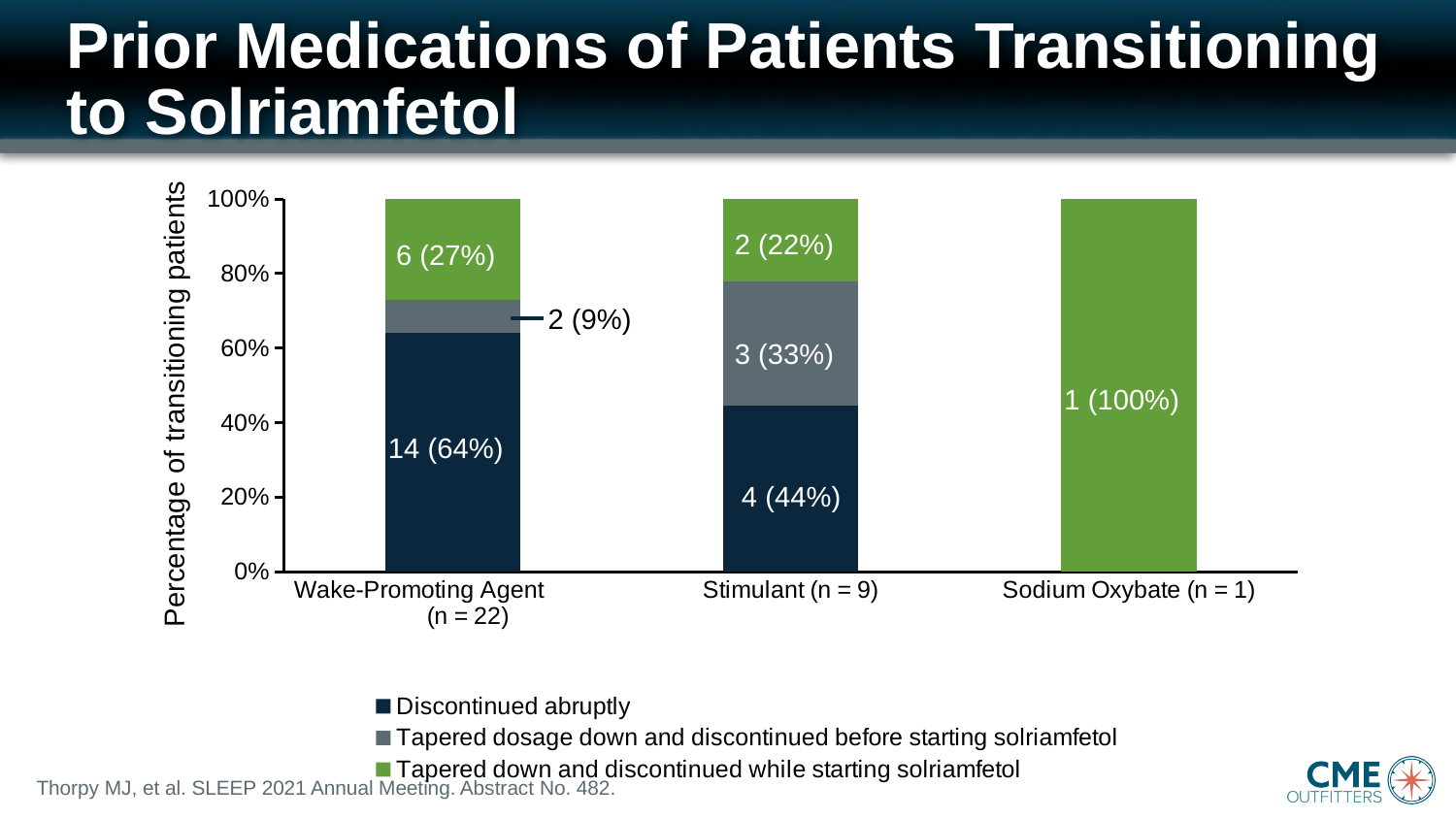
How many series does the legend list? 3 Which category has the highest percentage of patients who discontinued abruptly? Wake-Promoting Agent (n = 22) What is the label for the 'Tapered down and discontinued while starting solriamfetol' segment of the Stimulant (n = 9) bar? 2 (22%) What is the label for the 'Tapered dosage down and discontinued before starting solriamfetol' segment of the Wake-Promoting Agent (n = 22) bar? 2 (9%) What is the label shown on the Sodium Oxybate (n = 1) bar? 1 (100%) What is the label for the 'Discontinued abruptly' segment of the Stimulant (n = 9) bar? 4 (44%) What kind of chart is shown on the slide? Stacked bar chart Which is larger: the percentage of Stimulant patients who tapered dosage down and discontinued before starting solriamfetol, or the percentage of Wake-Promoting Agent patients who did so? Stimulant (n = 9) What is the y-axis title of the chart? Percentage of transitioning patients What is the label for the 'Discontinued abruptly' segment of the Wake-Promoting Agent (n = 22) bar? 14 (64%) How many prior medication categories are shown on the x axis? 3 What is the difference in the number of patients who discontinued abruptly between the Wake-Promoting Agent and Stimulant categories? 10